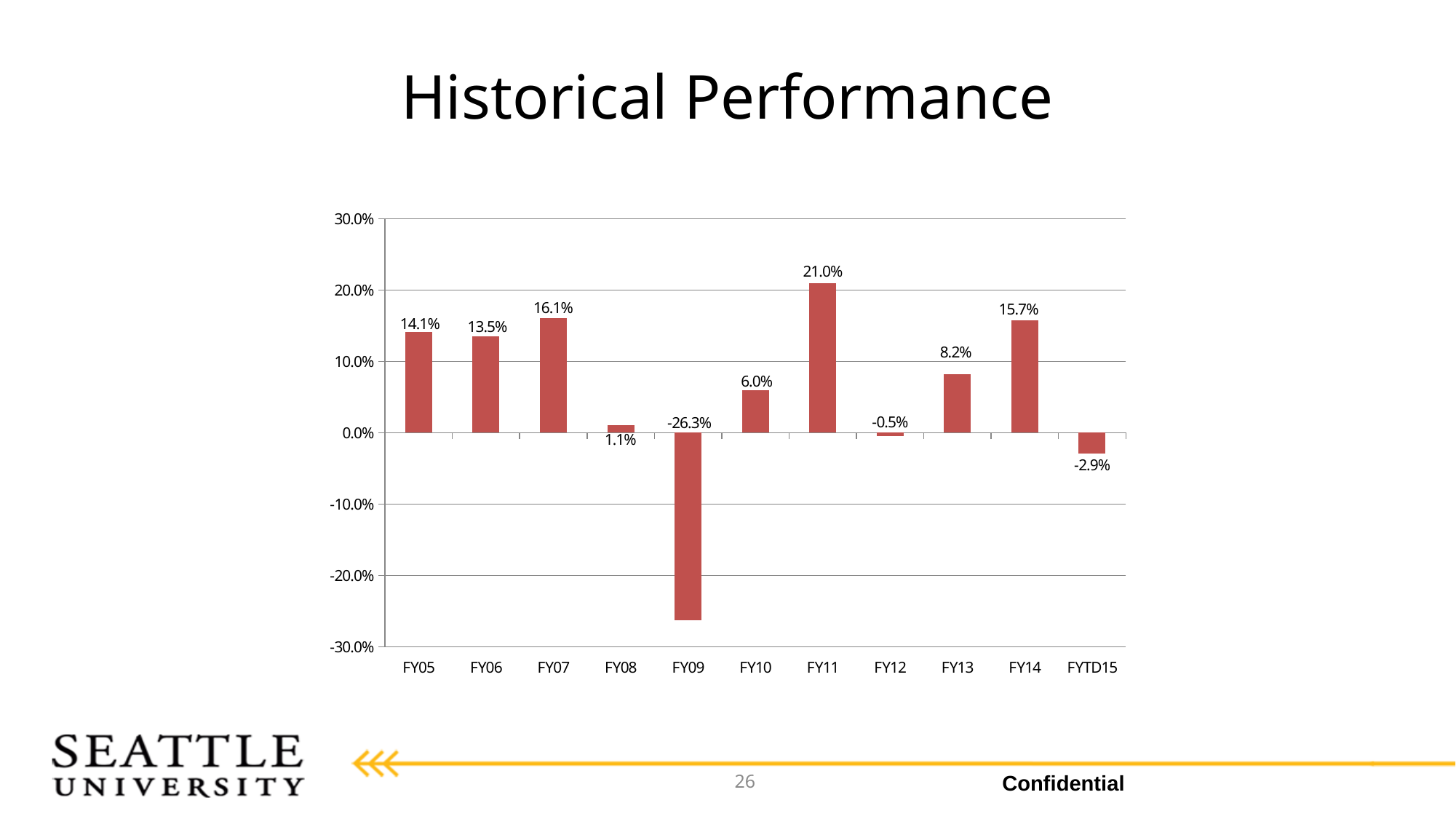
What is the title of the slide? Historical Performance What is the value for FYTD15? -2.9% How many fiscal years are shown on the x axis? 11 Which fiscal year has the highest value? FY11 What is the value for FY09? -26.3% What kind of chart is shown on the slide? Bar chart What is the value for FY11? 21.0% What is the value for FY08? 1.1% Which is larger, the value for FY05 or the value for FY14? FY14 How many fiscal years have a negative value? 3 Which fiscal year has the lowest value? FY09 What is the difference between the values for FY07 and FY06? 2.6%